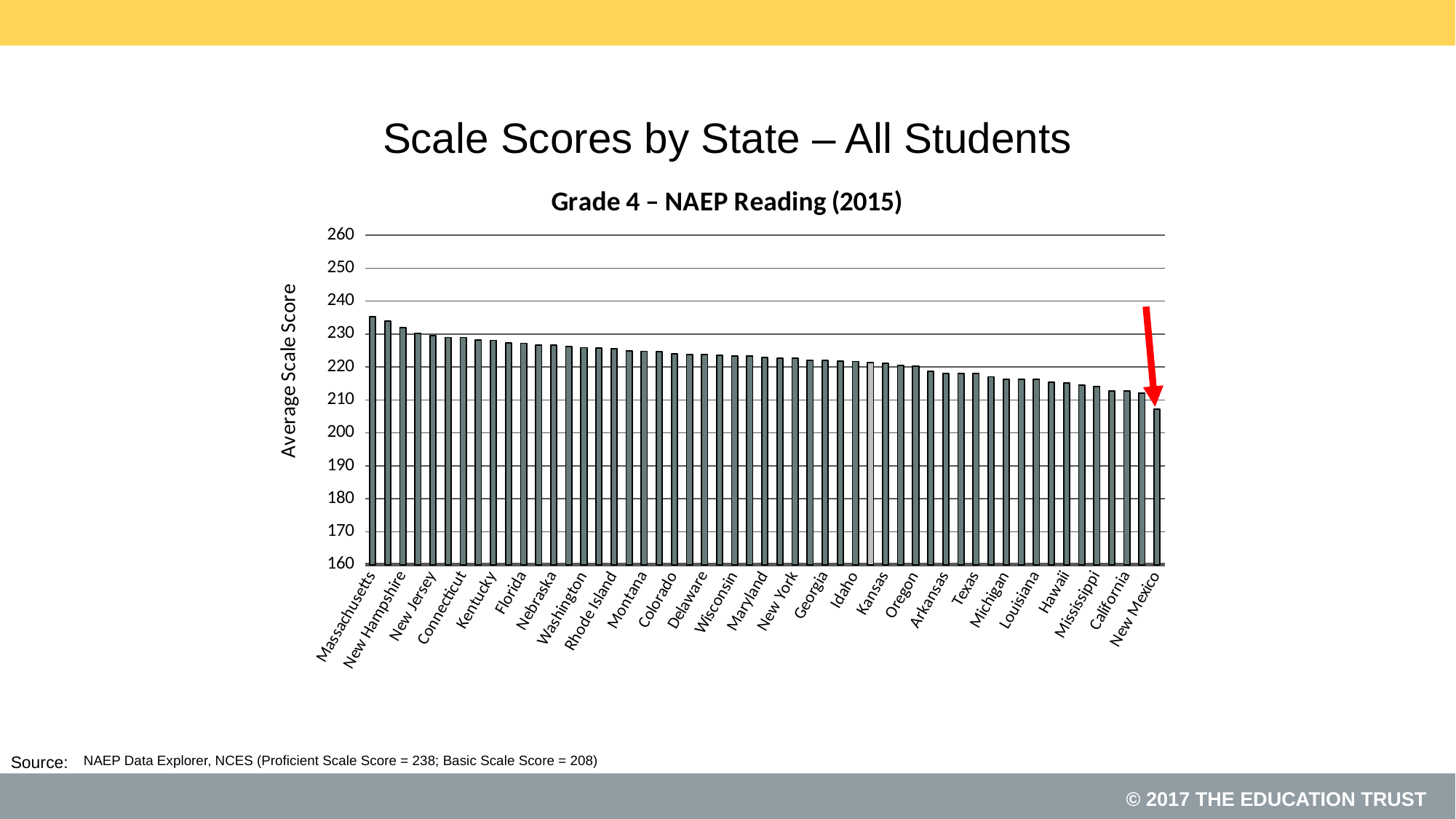
Is the value for Massachusetts greater or less than 230? greater Is the value for New Mexico greater or less than 210? less Which state has the highest average scale score in the chart? Massachusetts Which state has a higher average scale score, Florida or Hawaii? Florida Do the average scale scores rise or fall moving from left to right across the states? Fall Is the value for Texas greater or less than 220? less What is the label on the vertical axis of the chart? Average Scale Score Which state has the lowest average scale score in the chart? New Mexico Which state has a higher average scale score, California or New Jersey? New Jersey What is the title of the chart? Grade 4 – NAEP Reading (2015) What kind of chart is shown on the slide? Bar chart